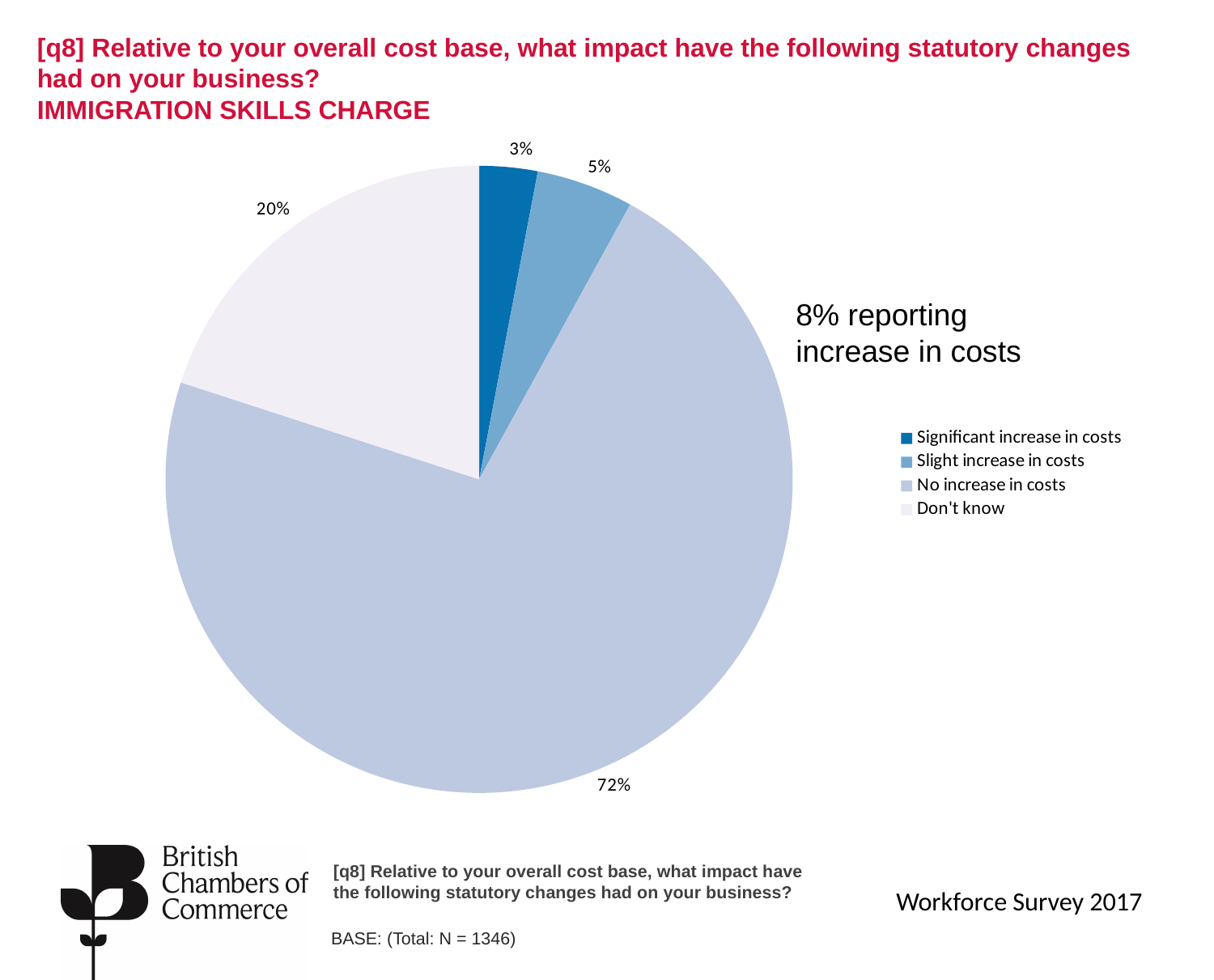
What is the difference in percentage points between 'No increase in costs' and 'Don't know'? 52 What is the combined share of respondents reporting a significant or slight increase in costs? 8% What percentage of respondents reported a slight increase in costs? 5% What is the base size (N) stated on the slide? 1346 What percentage of respondents reported no increase in costs? 72% What percentage of respondents answered 'Don't know'? 20% Which response category has the largest share of the pie? No increase in costs What type of chart is shown on the slide? Pie chart Which is larger: the share for 'Slight increase in costs' or 'Significant increase in costs'? Slight increase in costs What percentage of respondents reported a significant increase in costs from the Immigration Skills Charge? 3% How many categories does the legend list? 4 Which response category has the smallest share of the pie? Significant increase in costs